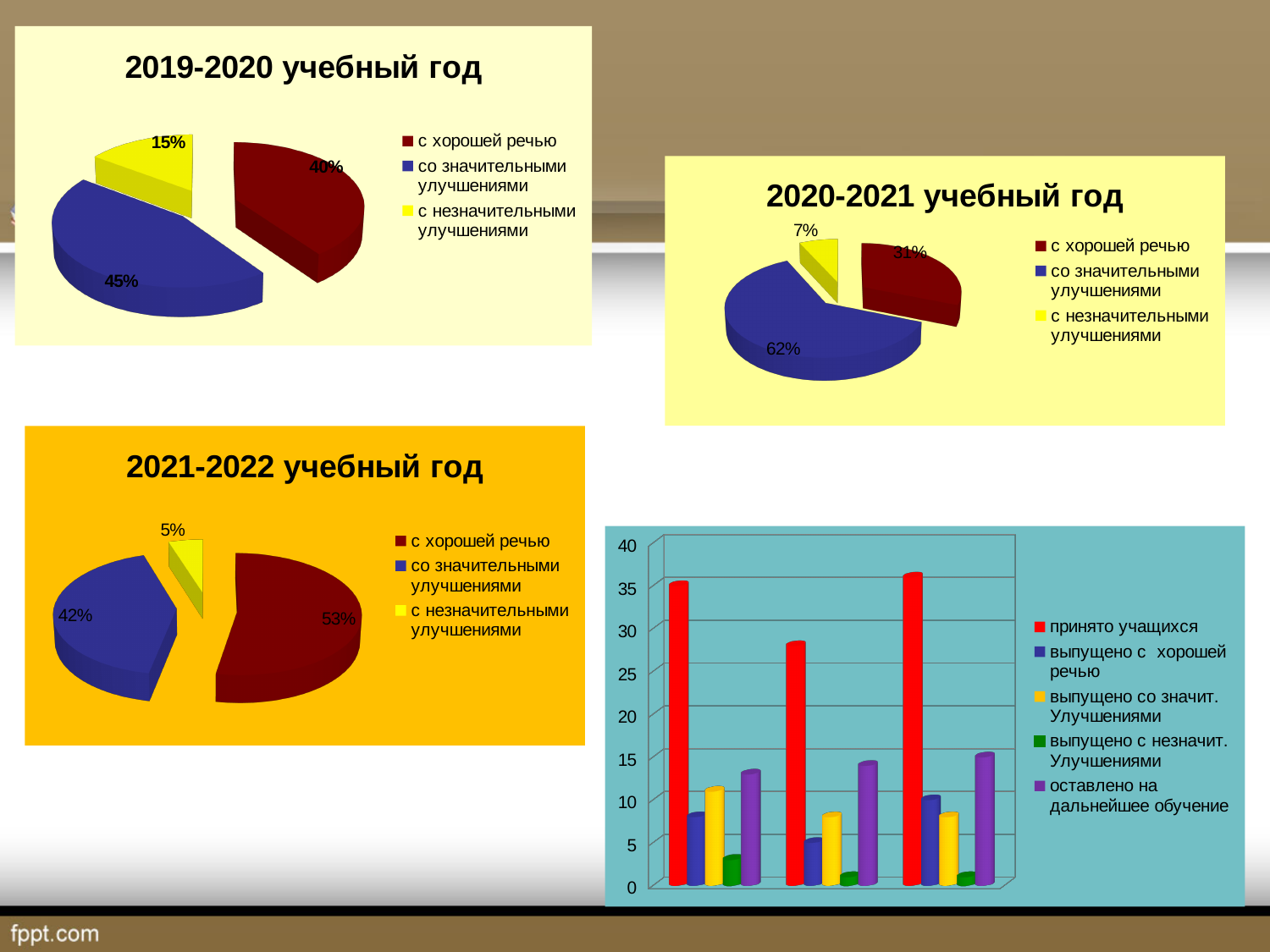
How many series does the legend of the bar chart at the bottom right of the slide list? 5 In the pie chart titled "2021-2022 учебный год", which is larger: the share for "с хорошей речью" or the share for "со значительными улучшениями"? с хорошей речью In the pie chart titled "2019-2020 учебный год", which category has the smallest slice? с незначительными улучшениями In the pie chart titled "2020-2021 учебный год", what share is labelled for "с хорошей речью"? 31% What kind of chart is the chart at the bottom right of the slide? bar chart In the pie chart titled "2020-2021 учебный год", what is the difference between the shares for "со значительными улучшениями" and "с хорошей речью"? 31% In the pie chart titled "2021-2022 учебный год", what share is labelled for "с незначительными улучшениями"? 5% How many slices does the pie chart titled "2021-2022 учебный год" have? 3 In the bar chart at the bottom right of the slide, is the value of the "принято учащихся" bar in the leftmost group greater or less than 30? greater In the pie chart titled "2019-2020 учебный год", what share is labelled for "со значительными улучшениями"? 45% In the pie chart titled "2020-2021 учебный год", which category has the largest slice? со значительными улучшениями In the bar chart at the bottom right of the slide, is the value of the "принято учащихся" bar in the middle group greater or less than 30? less